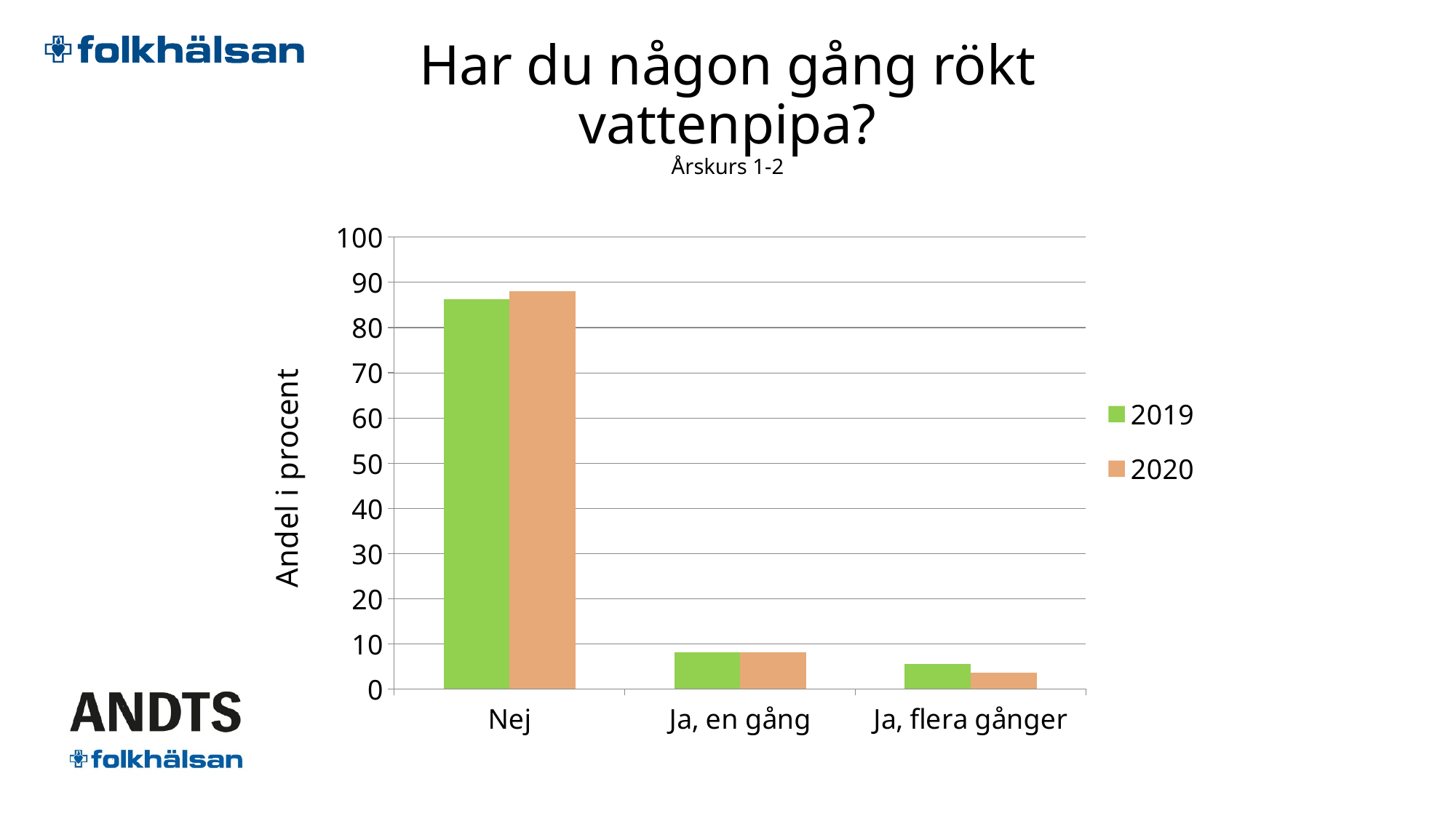
Which category has the lowest value for 2020? Ja, flera gånger Do the 2019 values rise or fall from left to right along the x axis? fall What kind of chart is shown on the slide? bar chart For Ja, flera gånger, which year has the larger value, 2019 or 2020? 2019 What is the label on the vertical axis? Andel i procent Which category has the highest value for 2019? Nej Is the value for Ja, en gång in 2019 greater or less than 10? less How many categories are shown on the x axis? 3 Which colour represents the 2020 series in the legend? orange Is the value for Ja, flera gånger in 2020 greater or less than 10? less Is the value for Nej in 2020 greater or less than 80? greater How many series does the legend list? 2